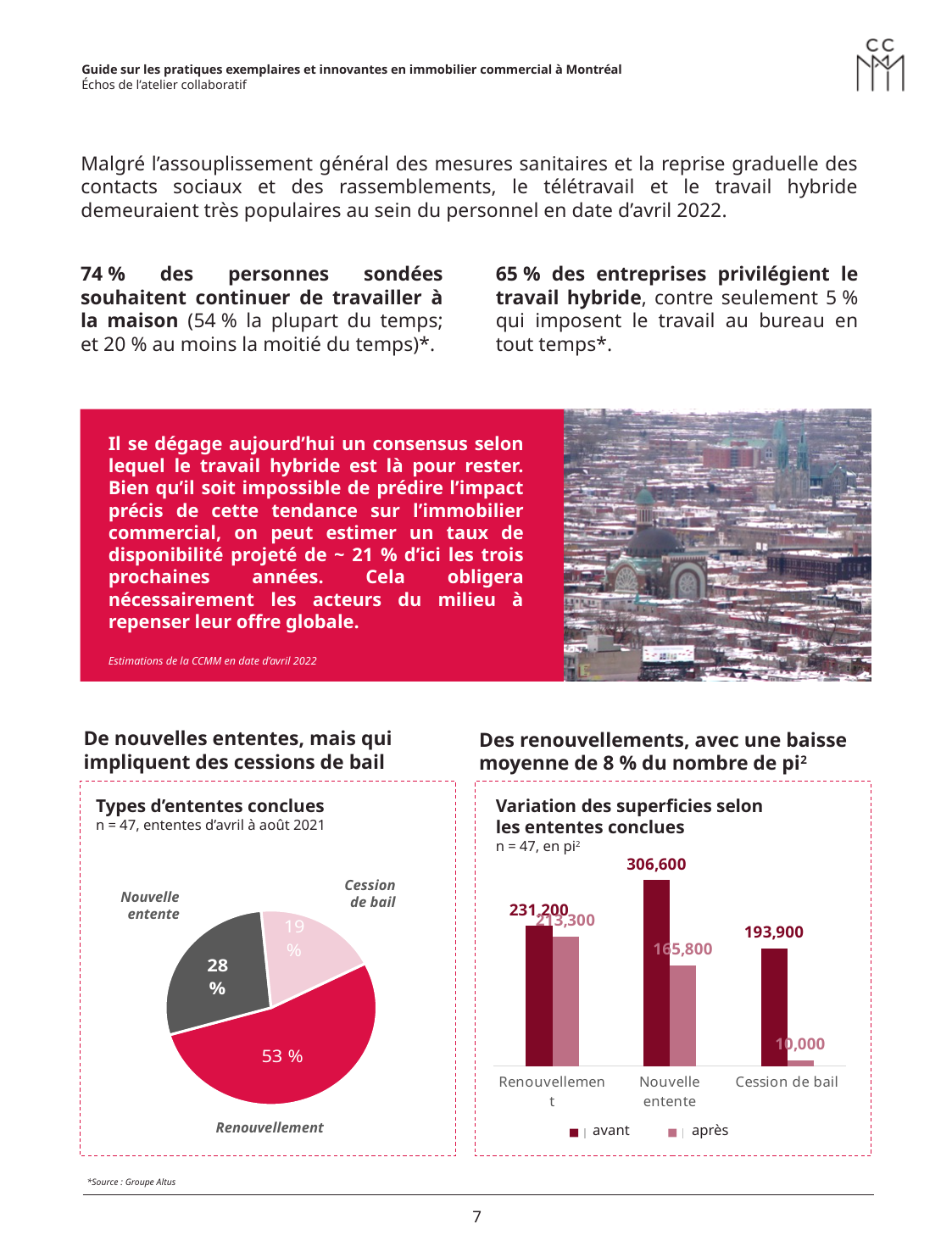
In the 'Variation des superficies selon les ententes conclues' chart, is the 'après' value for Nouvelle entente larger or smaller than the 'après' value for Renouvellement? Smaller In the 'Types d'ententes conclues' pie chart, which category has the smallest share? Cession de bail In the 'Variation des superficies selon les ententes conclues' chart, how many series does the legend list? 2 What kind of chart is 'Variation des superficies selon les ententes conclues'? Bar chart In the 'Variation des superficies selon les ententes conclues' chart, what is the 'avant' value for Nouvelle entente? 306,600 In the 'Variation des superficies selon les ententes conclues' chart, which category has the highest 'avant' value? Nouvelle entente What kind of chart is 'Types d'ententes conclues'? Pie chart In the 'Variation des superficies selon les ententes conclues' chart, what is the 'après' value for Cession de bail? 10,000 In the 'Variation des superficies selon les ententes conclues' chart, what is the difference between the 'avant' and 'après' values for Renouvellement? 17,900 In the 'Types d'ententes conclues' pie chart, what share is Renouvellement? 53 % In the 'Types d'ententes conclues' pie chart, what share is Nouvelle entente? 28 % In the 'Types d'ententes conclues' pie chart, how many slices are there? 3